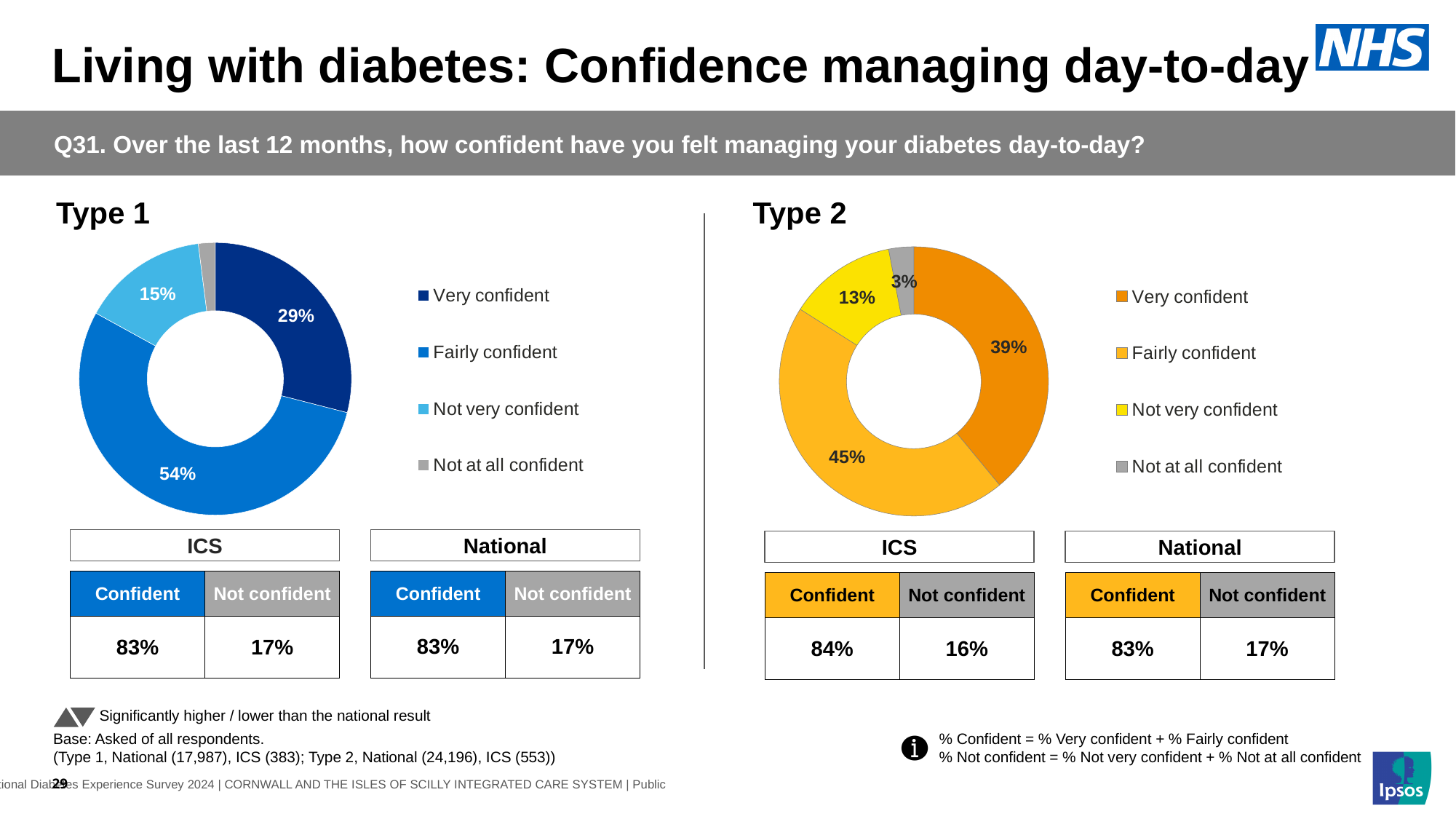
In the Type 1 chart, what percentage of respondents were fairly confident? 54% In the Type 1 chart, what is the difference between the fairly confident and not very confident shares? 39% In the Type 1 chart, what percentage of respondents were very confident? 29% In the Type 2 chart, what percentage of respondents were not very confident? 13% In the Type 2 chart, what is the difference between the fairly confident and very confident shares? 6% Which is larger in the Type 2 chart: the very confident share or the not very confident share? Very confident What kind of chart is used for the Type 1 data? Doughnut chart In the Type 2 chart, what percentage of respondents were not at all confident? 3% How many categories does the legend of the Type 2 chart list? 4 What colour represents the 'Not at all confident' category in the Type 1 chart? Grey In the Type 2 chart, which category has the smallest share? Not at all confident In the Type 1 chart, which category has the largest share? Fairly confident